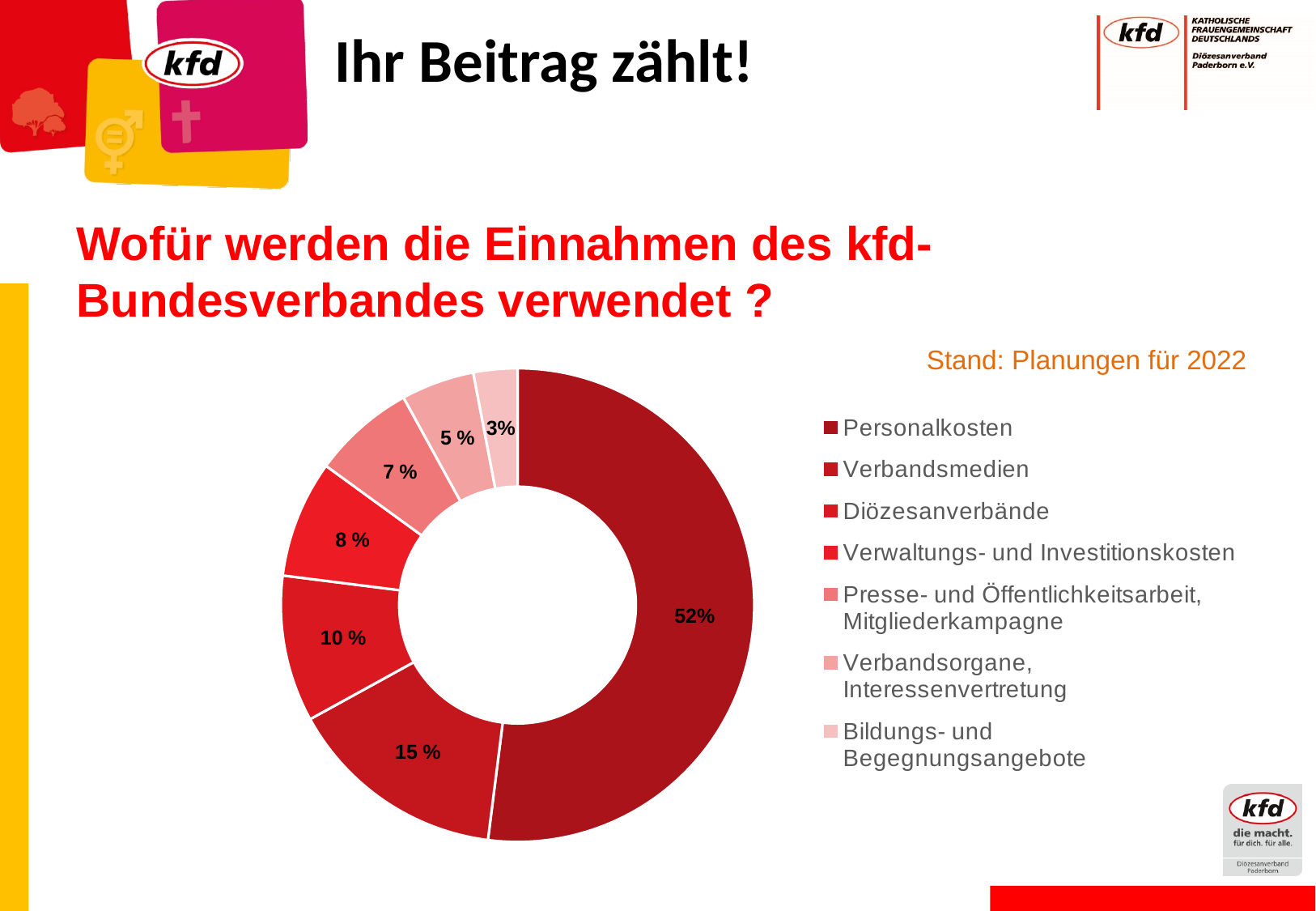
What percentage is shown for Verbandsmedien? 15 % What planning year does the chart refer to, according to the note on the slide? 2022 What percentage is shown for Bildungs- und Begegnungsangebote? 3% What share of the kfd-Bundesverband income goes to Personalkosten? 52% What is the difference in percentage points between Personalkosten and Verbandsmedien? 37 What percentage is shown for Verwaltungs- und Investitionskosten? 8 % How many categories does the legend list? 7 Which category has the largest share of the chart? Personalkosten Which category has the smallest share of the chart? Bildungs- und Begegnungsangebote What kind of chart is shown on the slide? Pie chart (doughnut) Which is larger: the share for Presse- und Öffentlichkeitsarbeit, Mitgliederkampagne or the share for Verbandsorgane, Interessenvertretung? Presse- und Öffentlichkeitsarbeit, Mitgliederkampagne What percentage is shown for Diözesanverbände? 10 %